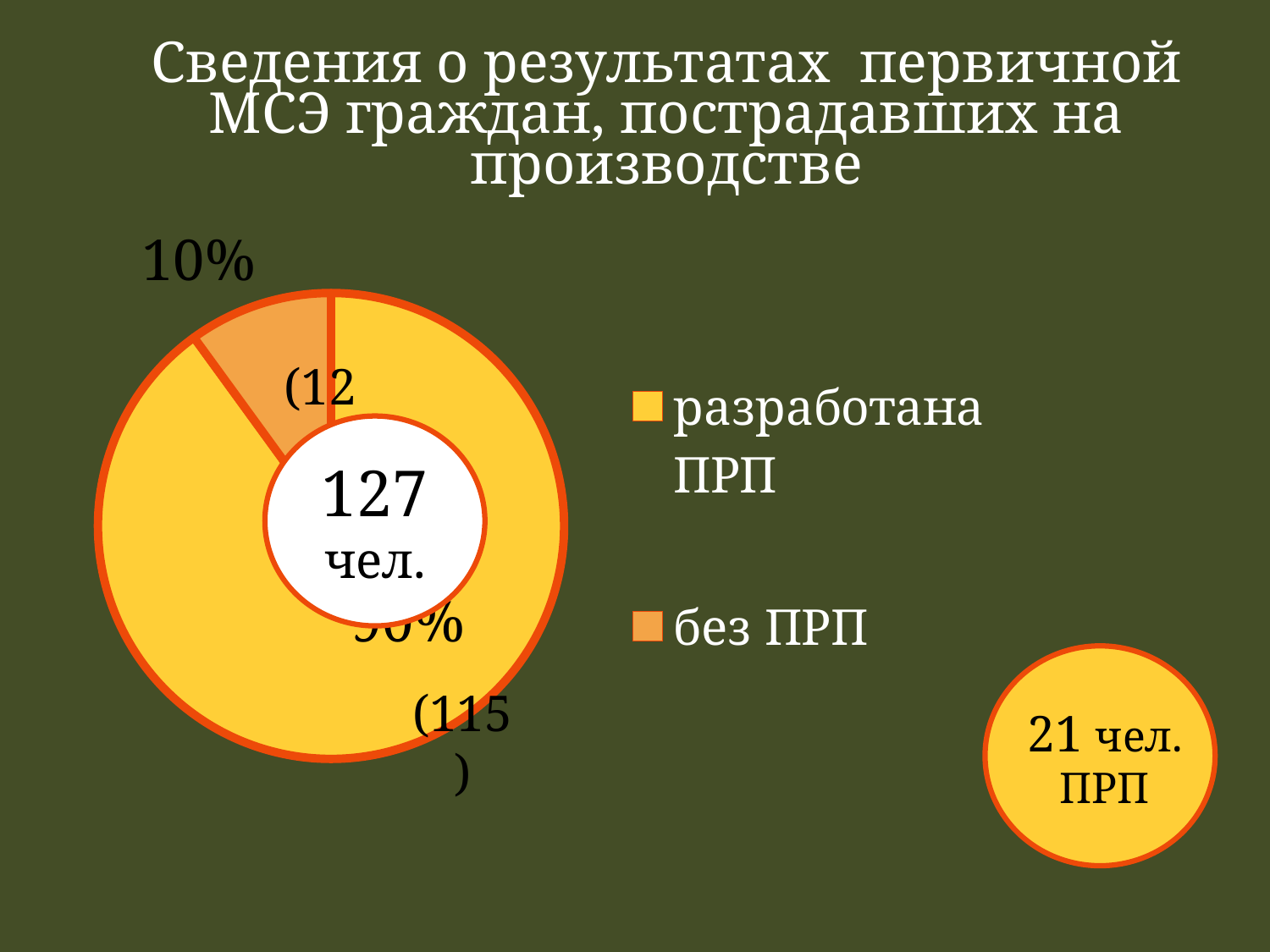
What colour is the без ПРП slice in the pie chart? orange Which category has the largest slice in the pie chart? разработана ПРП How many people are in the разработана ПРП slice of the pie chart? 115 What percentage of the pie chart is the slice for без ПРП? 10% Which is larger in the pie chart, разработана ПРП or без ПРП? разработана ПРП How many people are in the без ПРП slice of the pie chart? 12 What total is shown in the centre of the pie chart? 127 чел. Which category has the smallest slice in the pie chart? без ПРП How many entries does the legend of the pie chart list? 2 What kind of chart is shown on the slide? pie chart How many slices does the pie chart have? 2 What is the difference in number of people between разработана ПРП (115) and без ПРП (12)? 103